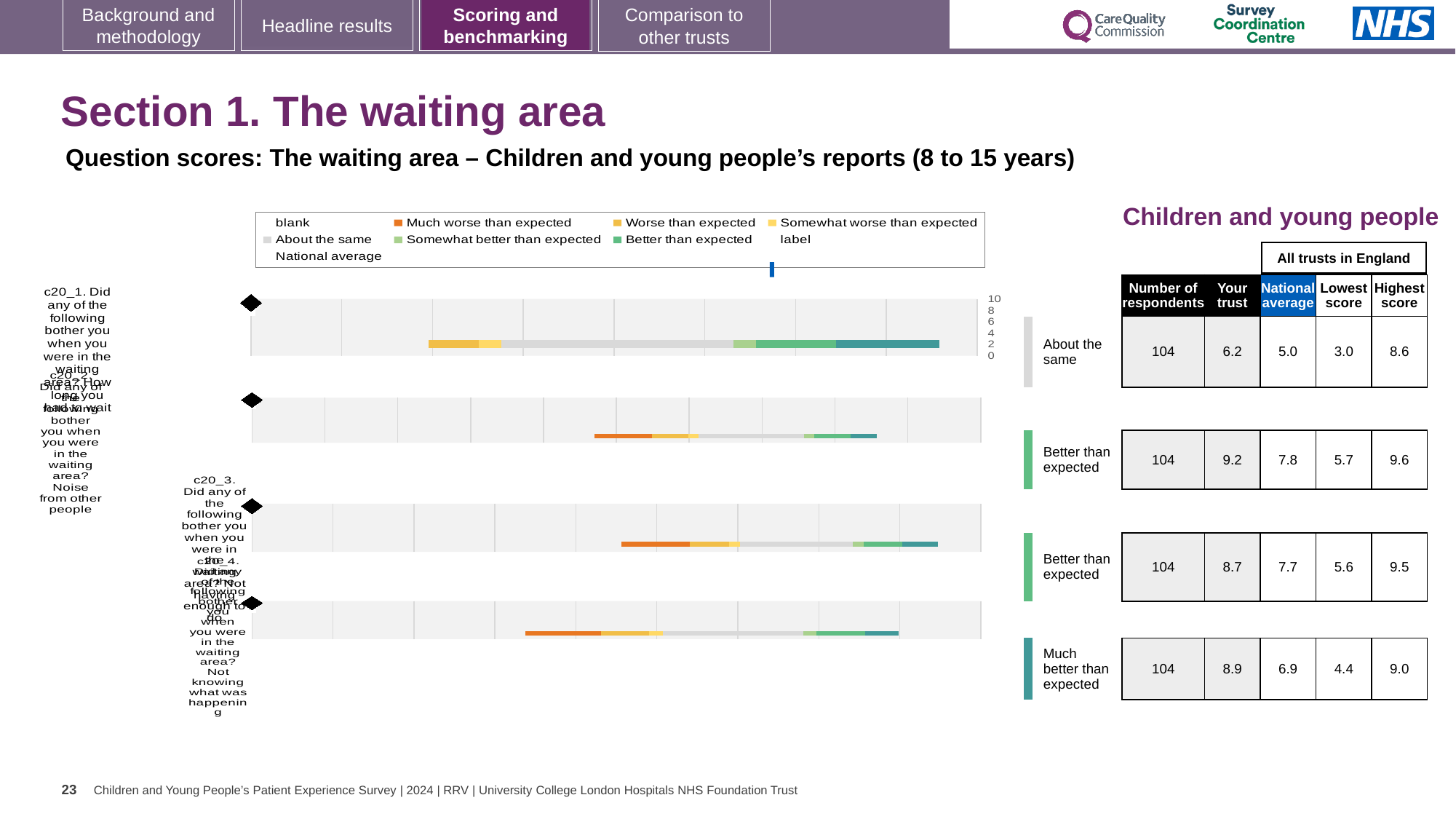
In the table, what is the number of respondents for the first row (About the same)? 104 In the table, what is the difference between the 'Your trust' score and the national average for the second row (Better than expected)? 1.4 In the table, which row has the highest 'Your trust' score? Better than expected (second row), 9.2 How many entries does the chart legend list? 9 In the table, what is the 'Your trust' score for the second row (Better than expected)? 9.2 In the table, is the 'Your trust' score for the third row (8.7) larger or smaller than its national average (7.7)? larger What is the heading printed above the table to the right of the chart? Children and young people In the table, which row has the lowest 'Lowest score' value? About the same (first row), 3.0 How many horizontal bars (questions) are plotted in the chart? 4 Which legend entry is shown in orange? Much worse than expected In the table, what is the national average for the fourth row (Much better than expected)? 6.9 What kind of chart is shown on the slide? bar chart